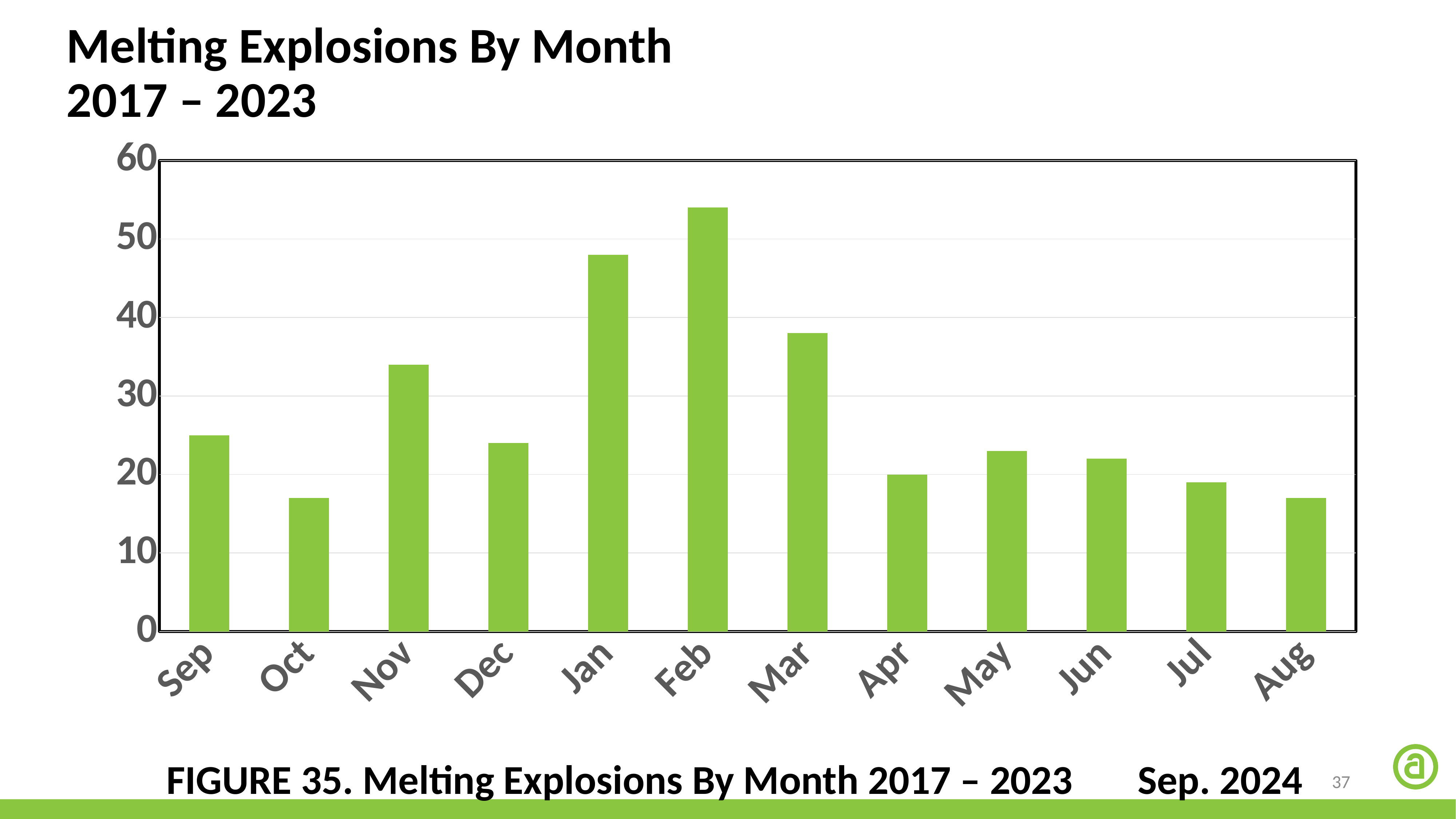
Is the value for Jan greater or less than 50? less How many months are plotted on the x axis? 12 Is the value for Feb greater or less than 50? greater Is the value for Nov greater or less than 30? greater Which month has the highest number of melting explosions? Feb Which is larger, the value for Nov or the value for Dec? Nov What kind of chart is shown on the slide? bar chart Which is larger, the value for Jan or the value for Mar? Jan What is the title of the chart? Melting Explosions By Month 2017 – 2023 Does the value rise or fall from Jan to Feb? rise